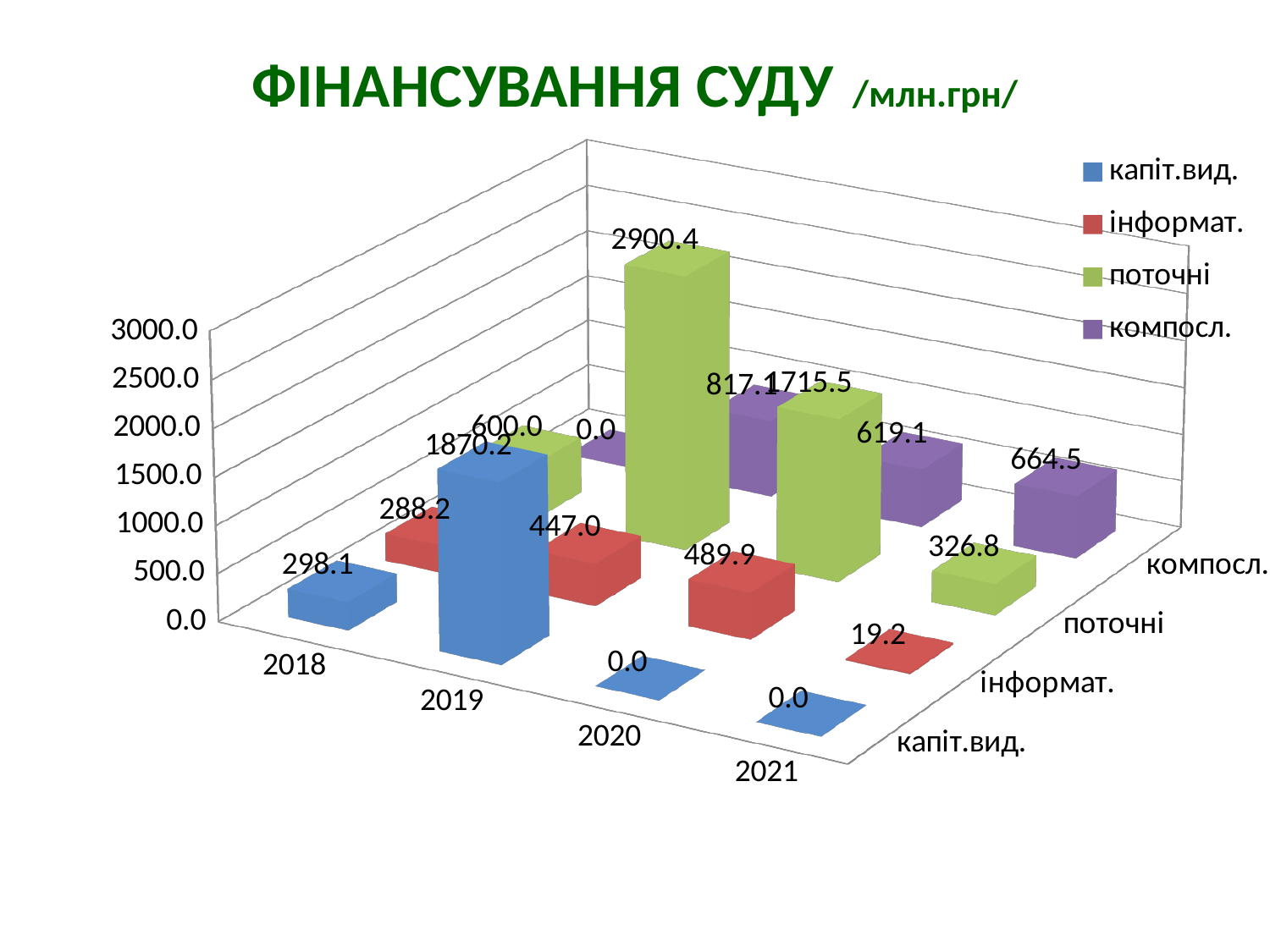
Which year has the lowest value for інформат.? 2021 What is the value for поточні in 2018? 600.0 What is the value for капіт.вид. in 2019? 1870.2 What is the difference between the поточні values for 2019 and 2020? 1184.9 What is the value for інформат. in 2021? 19.2 What is the value for компосл. in 2021? 664.5 How many series does the legend list? 4 What kind of chart is shown on the slide? bar chart Which is larger: компосл. in 2020 or компосл. in 2021? компосл. in 2021 Which year has the highest value for поточні? 2019 What is the value for поточні in 2019? 2900.4 How many years are shown on the x axis? 4